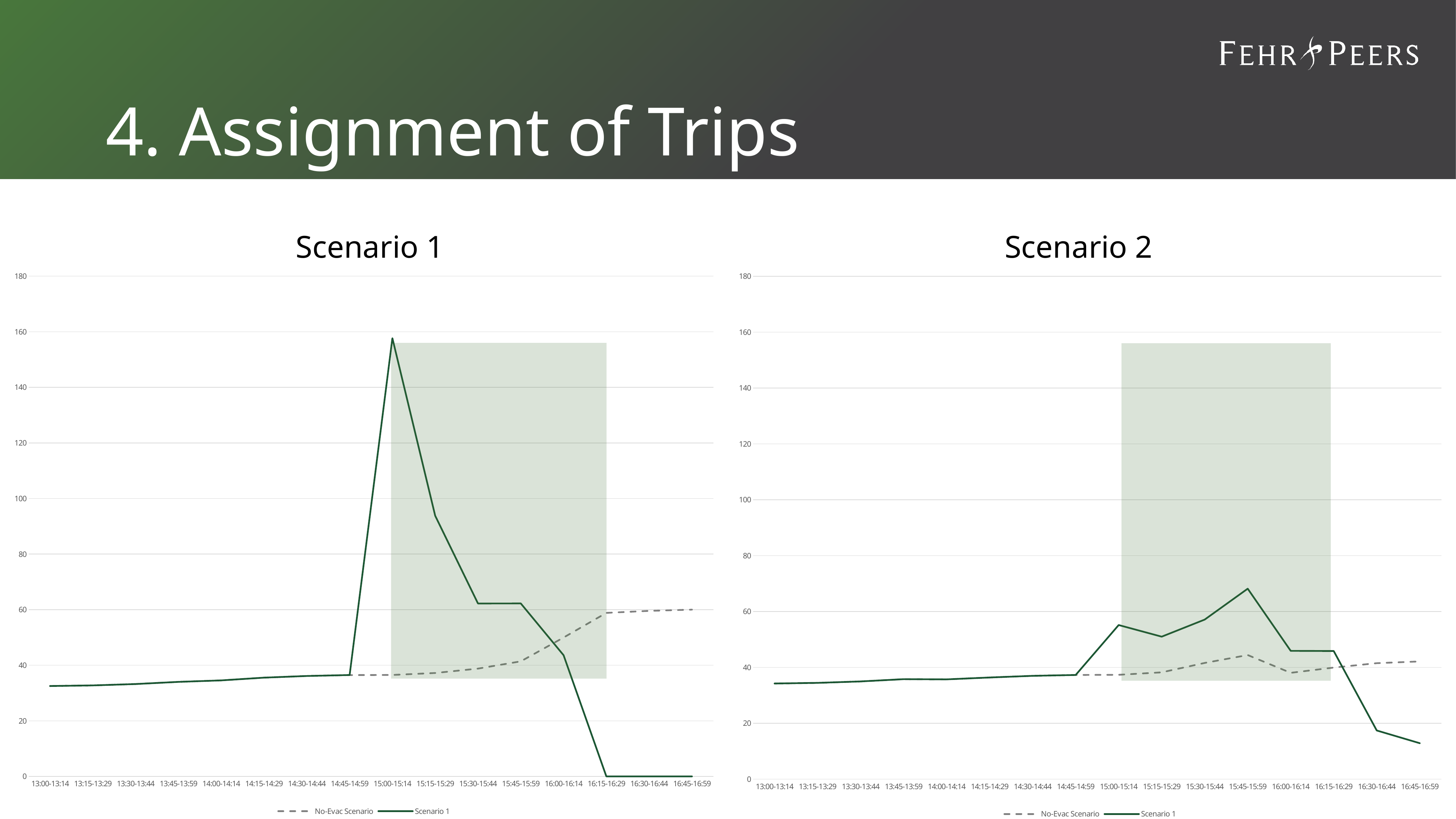
Which series is drawn with a dashed line in the Scenario 2 chart? No-Evac Scenario What kind of chart is the Scenario 1 chart? line chart In the Scenario 1 chart, is the value of the solid Scenario 1 line at 15:00-15:14 greater or less than 140? greater In the Scenario 1 chart, at which time period does the solid Scenario 1 line reach its highest value? 15:00-15:14 In the Scenario 1 chart, does the solid Scenario 1 line rise or fall from 15:00-15:14 to 16:30-16:44? fall In the Scenario 2 chart, is the value of the solid Scenario 1 line at 16:45-16:59 greater or less than 20? less In the Scenario 1 chart, does the dashed No-Evac Scenario line generally rise or fall from 13:00-13:14 to 16:45-16:59? rise How many series does the legend of the Scenario 1 chart list? 2 Which chart has the higher peak value for the solid Scenario 1 line, Scenario 1 or Scenario 2? Scenario 1 In the Scenario 1 chart, is the value of the solid Scenario 1 line at 16:00-16:14 greater or less than 60? less How many time periods are shown on the x axis of the Scenario 2 chart? 16 In the Scenario 2 chart, at which time period does the solid Scenario 1 line reach its highest value? 15:45-15:59